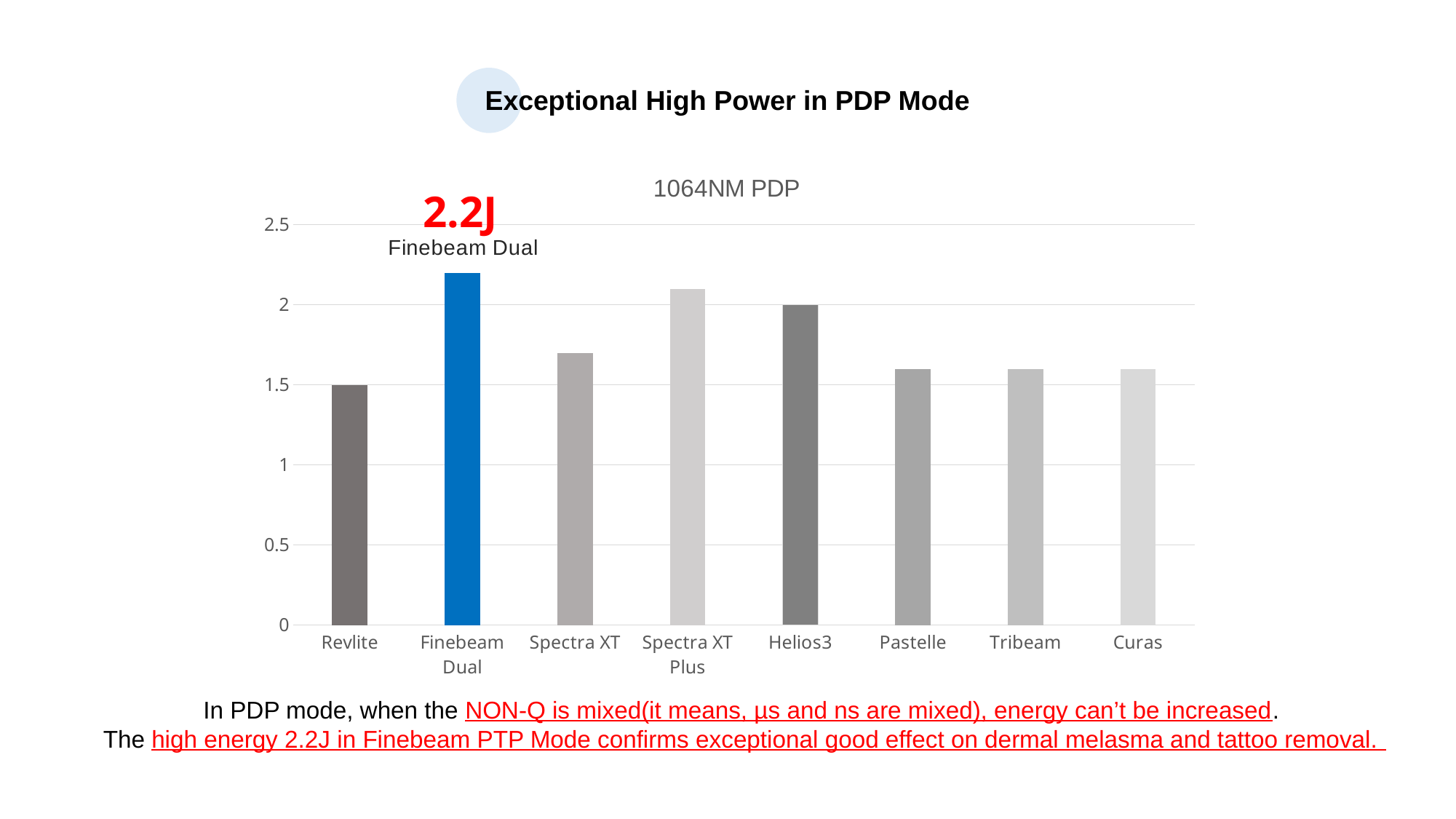
What is the difference between the values for Finebeam Dual and Revlite? 0.7 What is the value for Revlite in the 1064NM PDP chart? 1.5 What is the value for Helios3 in the 1064NM PDP chart? 2 Is the value for Spectra XT greater or less than 2? less Is the value for Spectra XT Plus greater or less than 2? greater Which device has the lowest value in the 1064NM PDP chart? Revlite What value is labelled for Finebeam Dual in the 1064NM PDP chart? 2.2J What kind of chart is shown on the slide? bar chart Which has a larger value, Spectra XT or Helios3? Helios3 How many devices are shown in the 1064NM PDP chart? 8 Is the value for Pastelle greater or less than 1.5? greater Which device has the highest value in the 1064NM PDP chart? Finebeam Dual